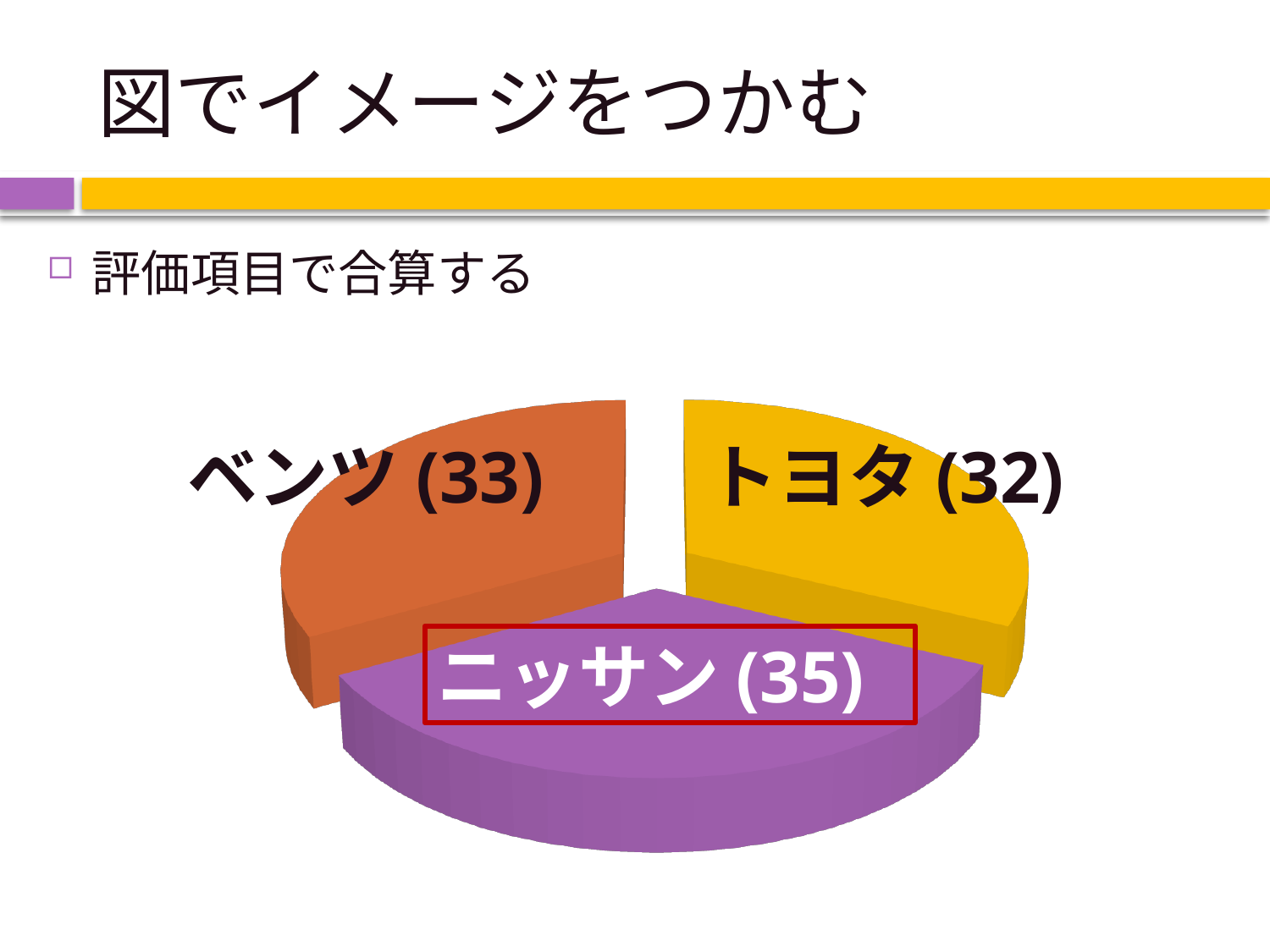
How many slices does the pie chart have? 3 What is the difference between the values for ベンツ and トヨタ? 1 What value is shown for ベンツ in the pie chart? 33 Which category has the smallest slice in the pie chart? トヨタ Which category has the largest slice in the pie chart? ニッサン What value is shown for トヨタ in the pie chart? 32 What colour is the ニッサン slice in the pie chart? purple What is the difference between the values for ニッサン and トヨタ? 3 What kind of chart is shown on the slide? pie chart What is the total of all three values in the pie chart? 100 What value is shown for ニッサン in the pie chart? 35 Which has a larger value, ニッサン or ベンツ? ニッサン